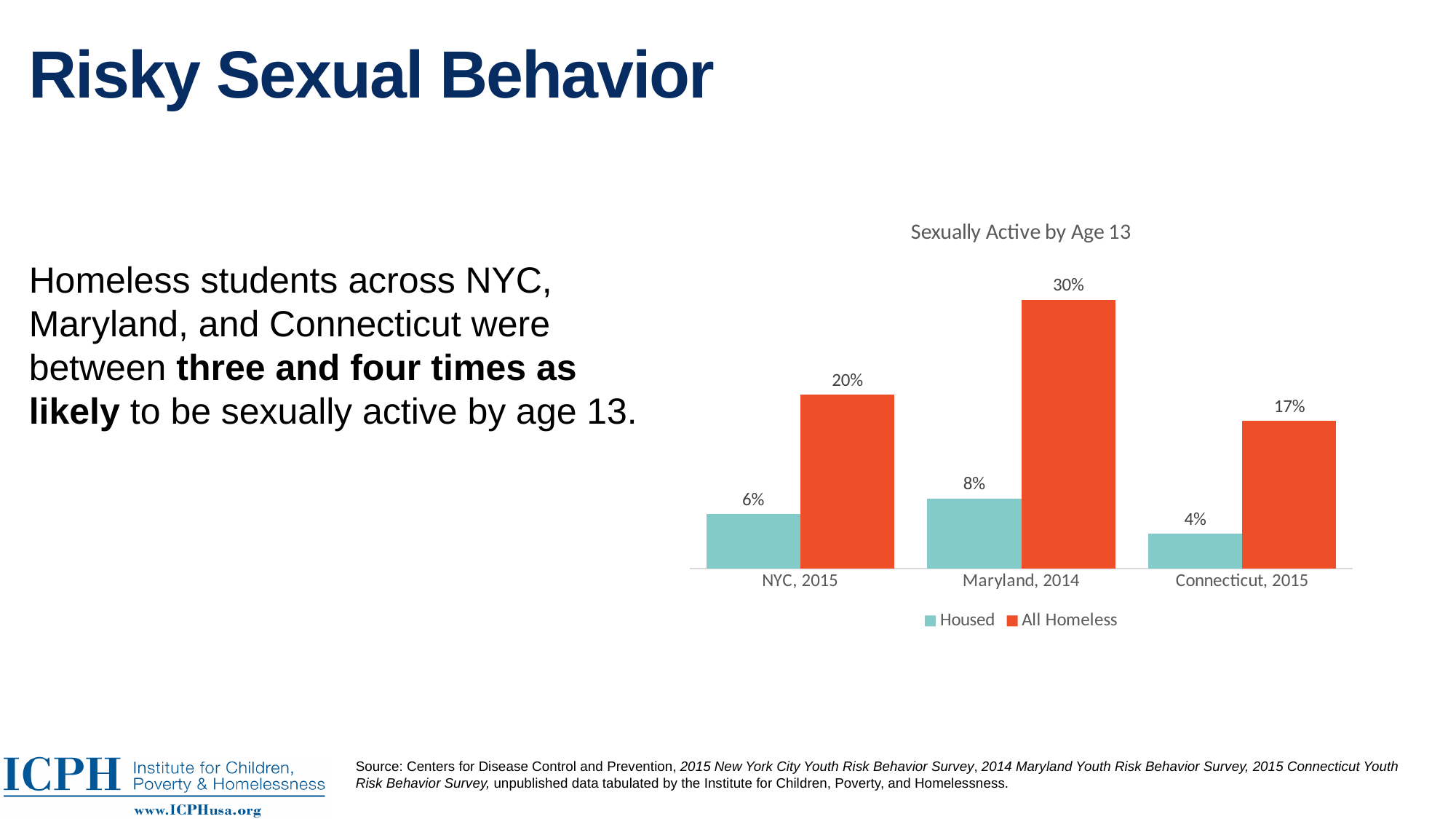
How many series does the legend list? 2 What is the value for All Homeless in Maryland, 2014? 30% What is the difference between the All Homeless values for NYC, 2015 and Connecticut, 2015? 3% What is the difference between the All Homeless and Housed values for Maryland, 2014? 22% Which category has the lowest Housed value? Connecticut, 2015 Which category has the highest All Homeless value? Maryland, 2014 What kind of chart is shown? Bar chart What is the value for All Homeless in NYC, 2015? 20% What is the title of the chart? Sexually Active by Age 13 How many categories are shown on the x axis? 3 What is the value for Housed in Connecticut, 2015? 4% Which is larger: the Housed value for NYC, 2015 or the Housed value for Maryland, 2014? Maryland, 2014